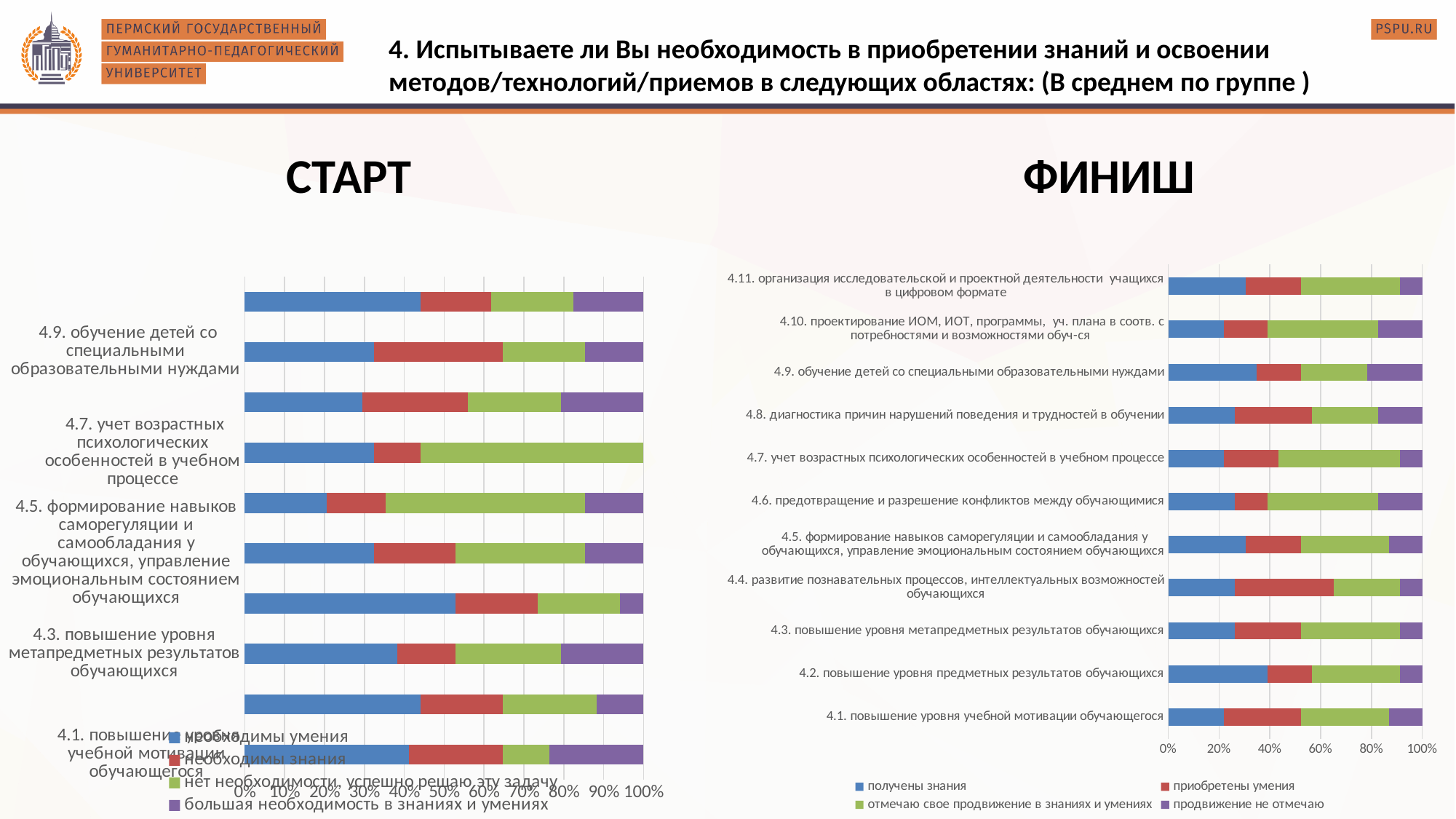
In the ФИНИШ chart, which category has the largest 'приобретены умения' segment? 4.4. развитие познавательных процессов, интеллектуальных возможностей обучающихся How many series does the legend of the СТАРТ chart list? 4 How many series does the legend of the ФИНИШ chart list? 4 How many categories are shown on the ФИНИШ chart? 11 What kind of chart is the ФИНИШ chart on the right? Bar chart In the СТАРТ chart, is the value for 'необходимы умения' for category 4.7 greater or less than 50%? less In the ФИНИШ chart, is the value for 'получены знания' for category 4.1 greater or less than 30%? less What kind of chart is the СТАРТ chart on the left? Bar chart In the ФИНИШ chart, is the 'приобретены умения' segment larger for category 4.4 or for category 4.10? 4.4 In the ФИНИШ chart, is the value for 'получены знания' for category 4.4 greater or less than 40%? less In the ФИНИШ chart, which colour represents 'продвижение не отмечаю'? Purple